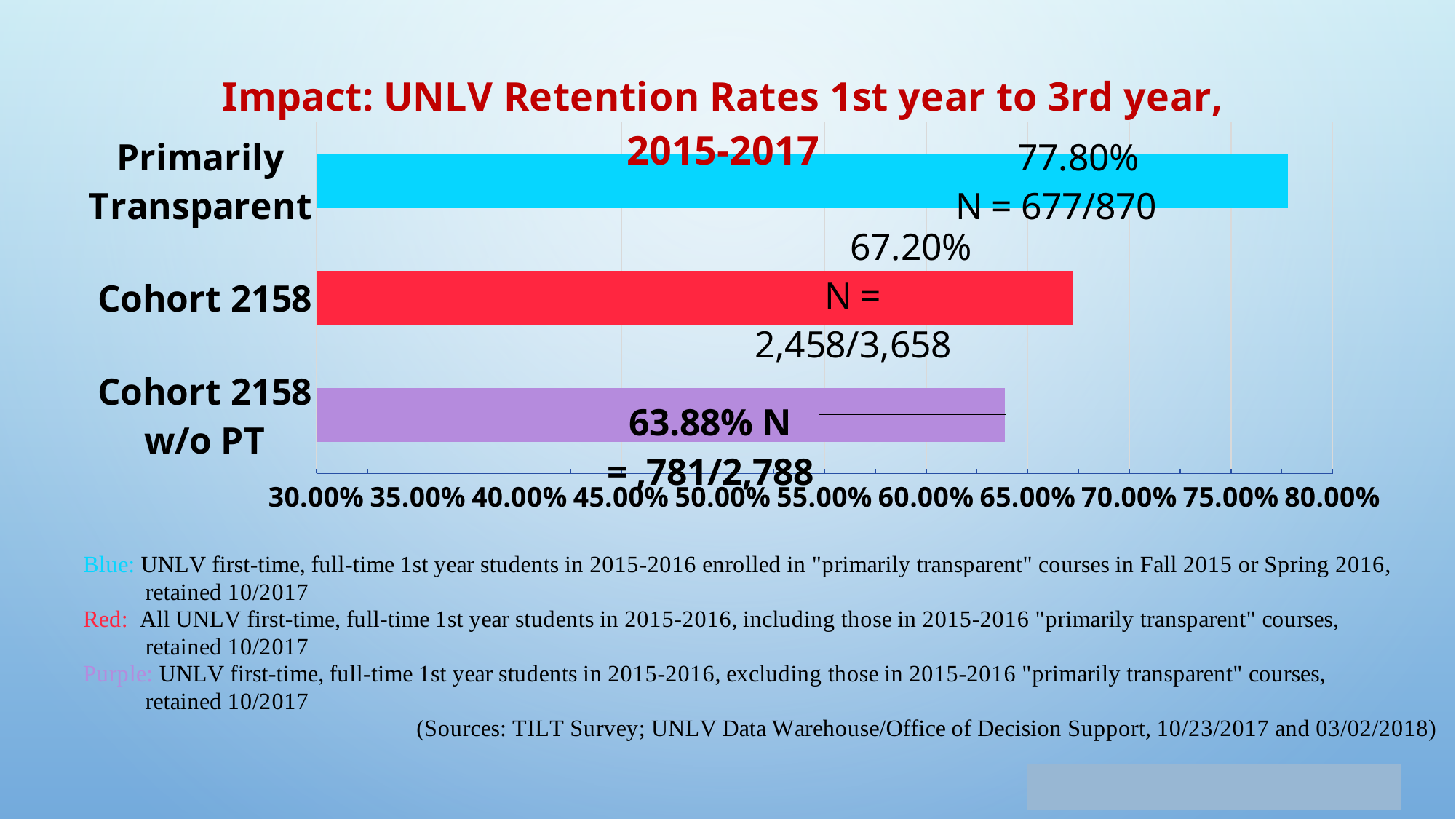
What is the retention rate for Cohort 2158 w/o PT? 63.88% What is the difference in retention rate between Primarily Transparent and Cohort 2158? 10.60% What is the retention rate for Cohort 2158? 67.20% Which has a higher retention rate, Cohort 2158 or Cohort 2158 w/o PT? Cohort 2158 What type of chart is shown on the slide? Bar chart What is the N value shown for Primarily Transparent? N = 677/870 Which category has the lowest retention rate? Cohort 2158 w/o PT Which category has the highest retention rate? Primarily Transparent What is the retention rate for Primarily Transparent? 77.80% What is the title of the chart? Impact: UNLV Retention Rates 1st year to 3rd year, 2015-2017 How many categories are shown in the chart? 3 What is the N value shown for Cohort 2158 w/o PT? N = 781/2,788